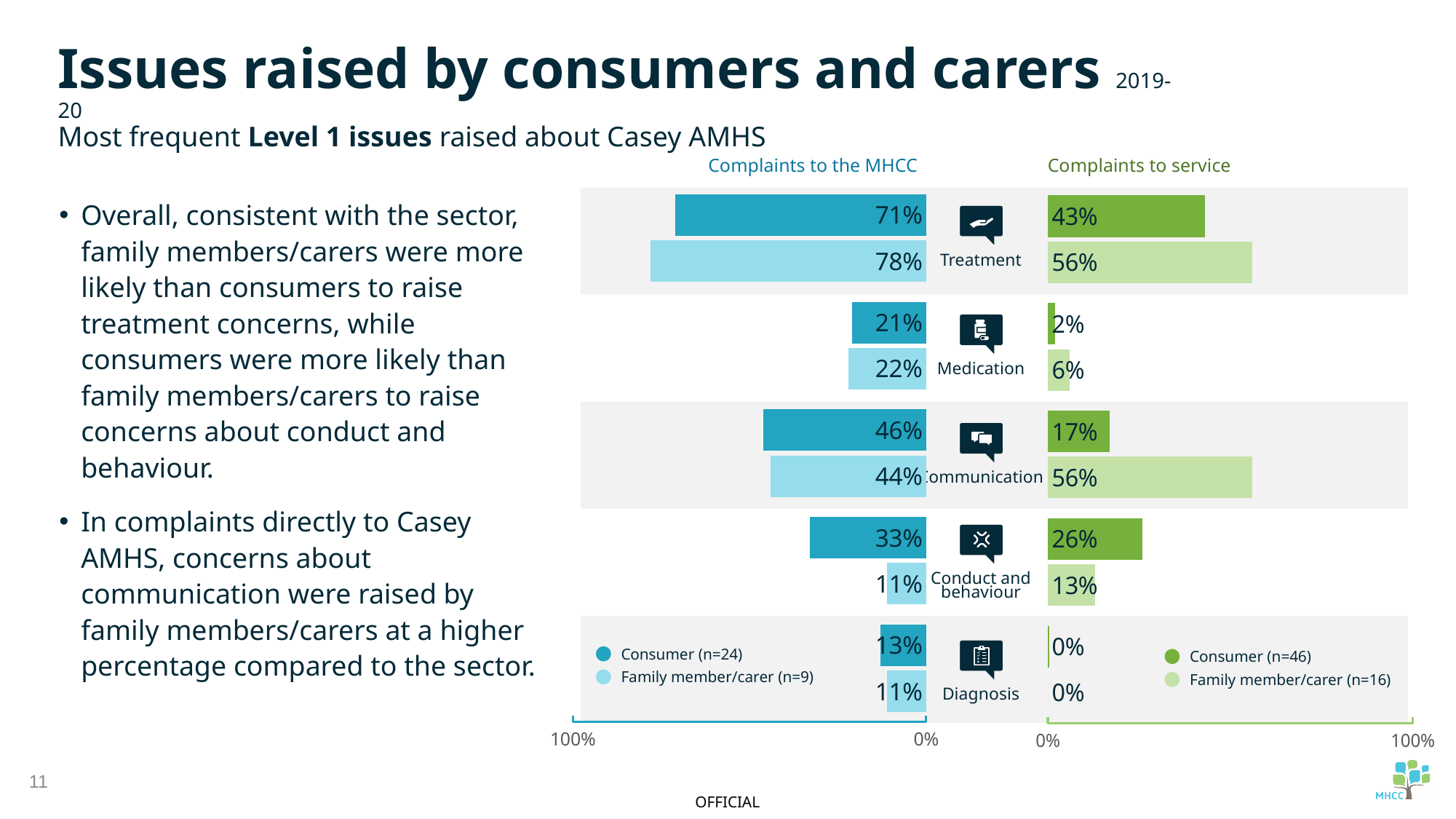
In the 'Complaints to service' chart, what percentage of family members/carers raised Communication issues? 56% How many issue categories are shown in the charts? 5 In the 'Complaints to the MHCC' chart, what is the difference between the consumer and family member/carer percentages for Conduct and behaviour? 22% In the 'Complaints to the MHCC' chart, which issue has the highest percentage for consumers? Treatment In the 'Complaints to the MHCC' chart, what percentage of family members/carers raised Treatment issues? 78% In the 'Complaints to service' chart, what percentage of consumers raised Medication issues? 2% In the 'Complaints to the MHCC' chart, which is larger for Communication: the consumer percentage or the family member/carer percentage? Consumer In the 'Complaints to service' chart, which issue has the lowest percentage for family members/carers? Diagnosis How many series does the legend of the 'Complaints to service' chart list? 2 In the 'Complaints to the MHCC' chart, what percentage of consumers raised Treatment issues? 71% In the 'Complaints to service' chart, what is the difference between the family member/carer and consumer percentages for Communication? 39% What type of chart is used to show the complaints data on this slide? Bar chart